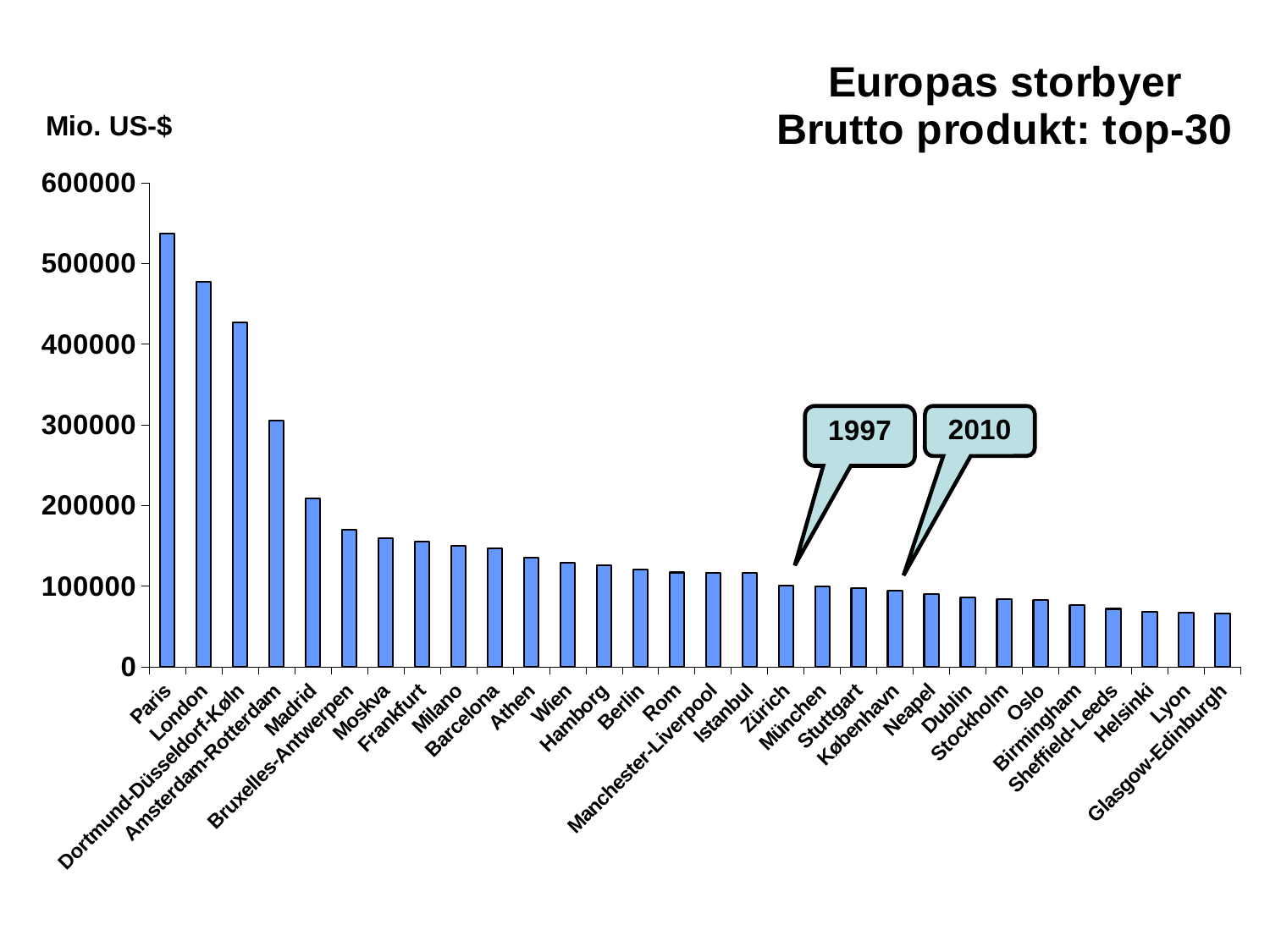
Which has the larger gross product, London or Madrid? London Is the value for London greater or less than 500000? less How many cities or city regions are shown on the chart? 30 Is the value for Helsinki greater or less than 100000? less Is the value for Bruxelles-Antwerpen greater or less than 200000? less What kind of chart is shown on the slide? Bar chart What unit is given for the y axis of the chart? Mio. US-$ Do the values rise or fall moving from left to right along the x axis? Fall Which city region has the lowest gross product on the chart? Glasgow-Edinburgh Which city has the highest gross product on the chart? Paris